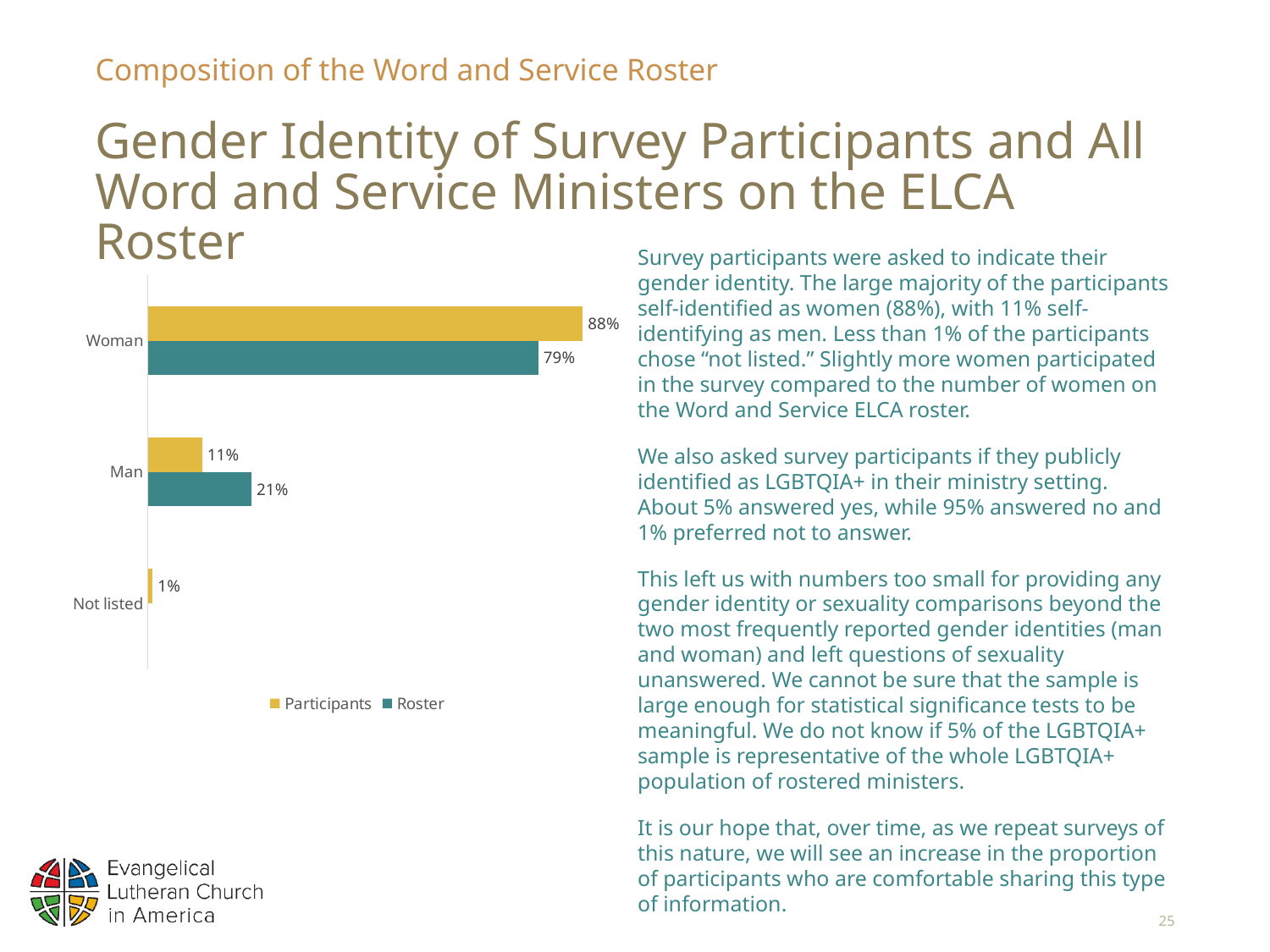
What is the difference between the Roster and Participants values for Man? 10% What is the difference between the Participants and Roster values for Woman? 9% How many series does the legend list? 2 What is the Roster value for Woman? 79% Which gender identity category has the highest Participants value? Woman What percentage of survey participants identified as women? 88% What is the Roster value for Man? 21% What is the Participants value for Not listed? 1% What is the Participants value for Man? 11% How many gender identity categories are shown on the chart? 3 Which gender identity category has the lowest Participants value? Not listed For Man, which is larger: the Participants value or the Roster value? Roster